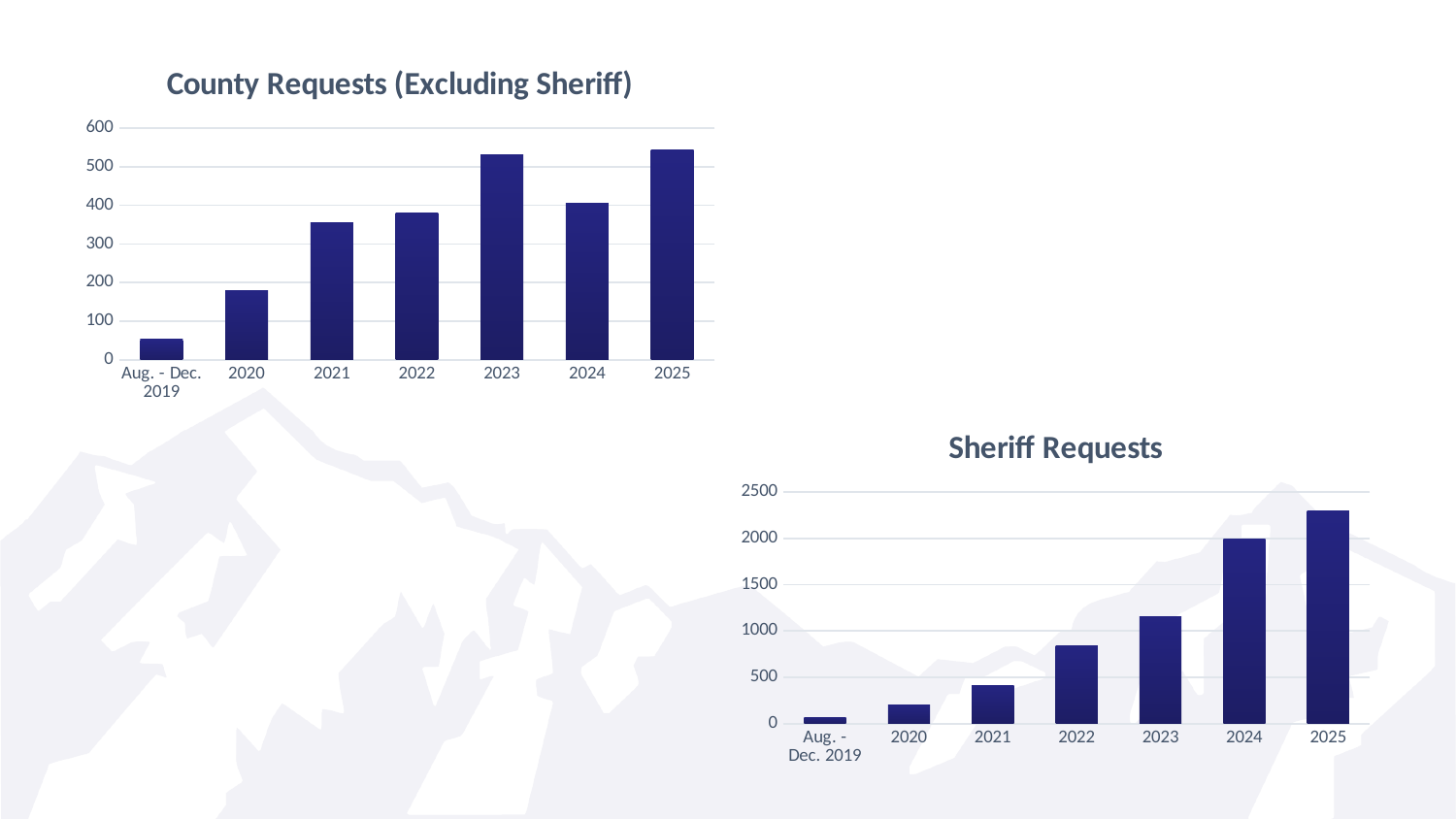
In the County Requests (Excluding Sheriff) chart, which category has the lowest value? Aug. - Dec. 2019 In the Sheriff Requests chart, is the value for 2025 greater or less than 2000? greater How many categories are shown on the x axis of the Sheriff Requests chart? 7 In the County Requests (Excluding Sheriff) chart, is the value for 2020 greater or less than 200? less In the Sheriff Requests chart, is the value for 2022 greater or less than 1000? less What kind of chart is the County Requests (Excluding Sheriff) chart? Bar chart In the Sheriff Requests chart, which is larger, the value for 2023 or the value for 2024? 2024 In the Sheriff Requests chart, which category has the lowest value? Aug. - Dec. 2019 In the County Requests (Excluding Sheriff) chart, which is larger, the value for 2023 or the value for 2024? 2023 In the Sheriff Requests chart, do the values rise or fall from 2020 to 2025? Rise In the Sheriff Requests chart, which year has the highest value? 2025